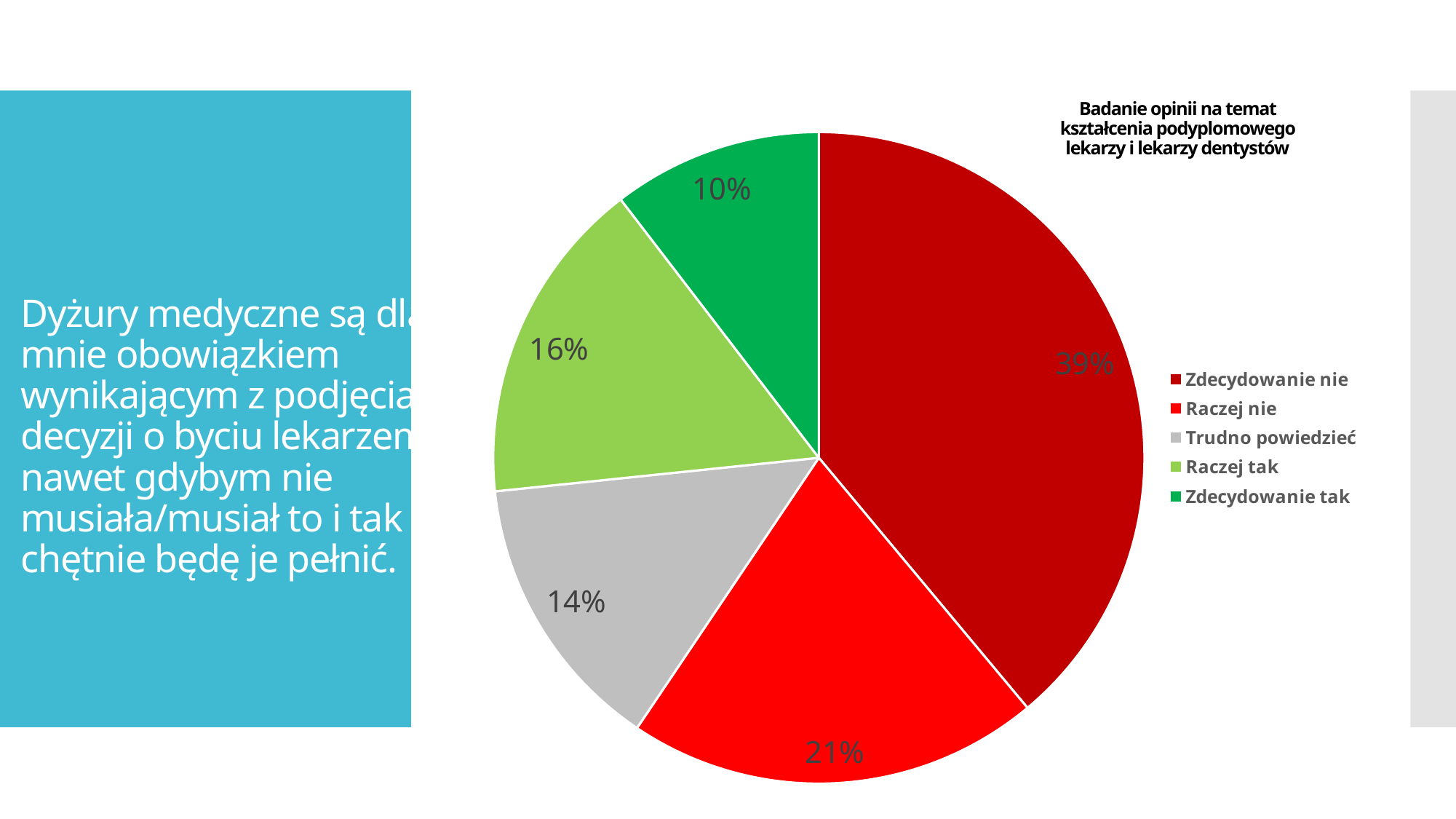
Which category has the smallest slice of the pie? Zdecydowanie tak Which category has the largest slice of the pie? Zdecydowanie nie What share of the pie does "Zdecydowanie nie" have? 39% What kind of chart is shown on the slide? pie chart Which is larger, the slice for "Raczej tak" or the slice for "Trudno powiedzieć"? Raczej tak What colour is the slice for "Trudno powiedzieć"? grey How many categories does the legend list? 5 What share of the pie does "Raczej nie" have? 21% What is the difference in percentage points between "Zdecydowanie nie" and "Raczej nie"? 18 What share of the pie does "Zdecydowanie tak" have? 10% What share of the pie does "Trudno powiedzieć" have? 14% What share of the pie does "Raczej tak" have? 16%